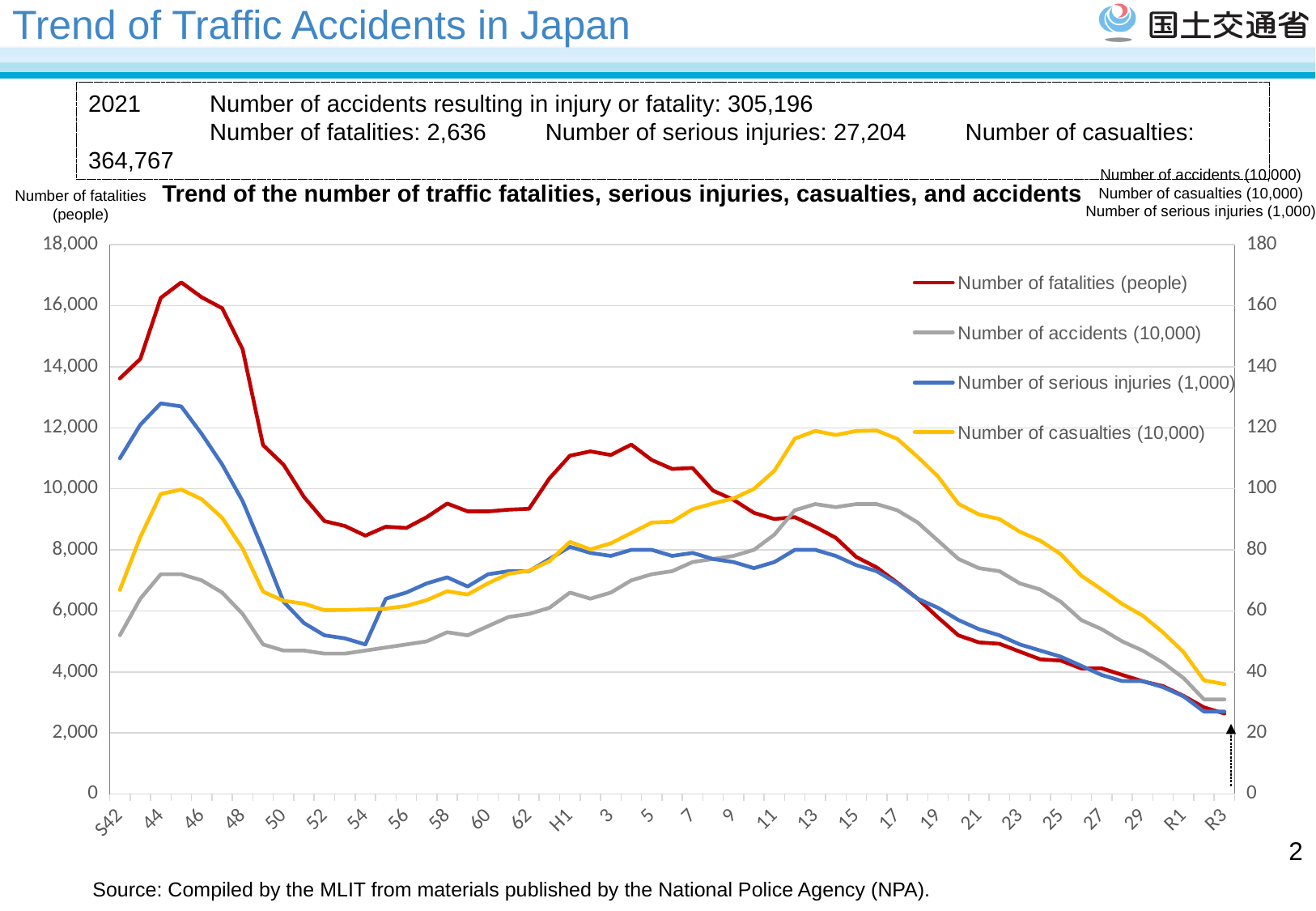
What is the title of the chart? Trend of the number of traffic fatalities, serious injuries, casualties, and accidents Does the Number of fatalities (people) series rise or fall from 17 to R3? fall Is the value for Number of fatalities (people) at S42 greater or less than 12,000? greater Is the peak value of Number of fatalities (people) greater or less than 16,000? greater Does the Number of casualties (10,000) series rise or fall from H1 to 13? rise Which colour is used for the 'Number of casualties (10,000)' series? yellow Is the peak value of Number of casualties (10,000) greater or less than 100 on the right axis? greater How many series does the chart legend list? 4 Which is larger for Number of fatalities (people): the value at S42 or the value at R3? S42 What kind of chart is shown on the slide? line chart